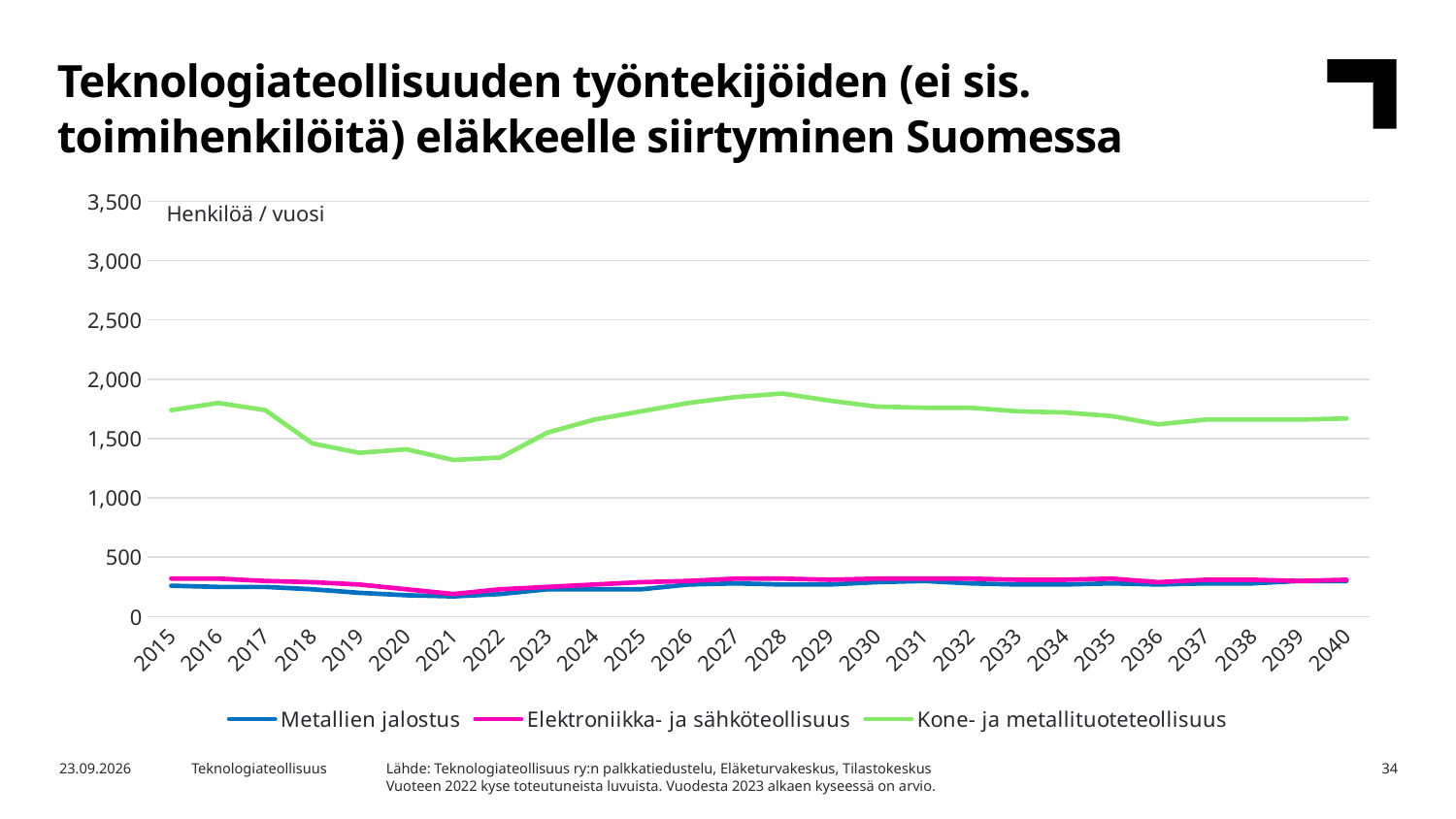
Is the value for Metallien jalostus in 2021 greater or less than 500? less Is the value for Kone- ja metallituoteteollisuus in 2028 greater or less than 2,000? less Is the value for Kone- ja metallituoteteollisuus in 2028 greater or less than 1,500? greater Does the Kone- ja metallituoteteollisuus line rise or fall from 2015 to 2021? fall Which series has the highest values across the whole period? Kone- ja metallituoteteollisuus How many series does the legend list? 3 What unit label is shown at the top of the chart's y axis? Henkilöä / vuosi Which is larger in 2030, the value for Kone- ja metallituoteteollisuus or the value for Metallien jalostus? Kone- ja metallituoteteollisuus What kind of chart is shown on the slide? line chart Does the Kone- ja metallituoteteollisuus line rise or fall from 2021 to 2028? rise How many years are shown on the x axis? 26